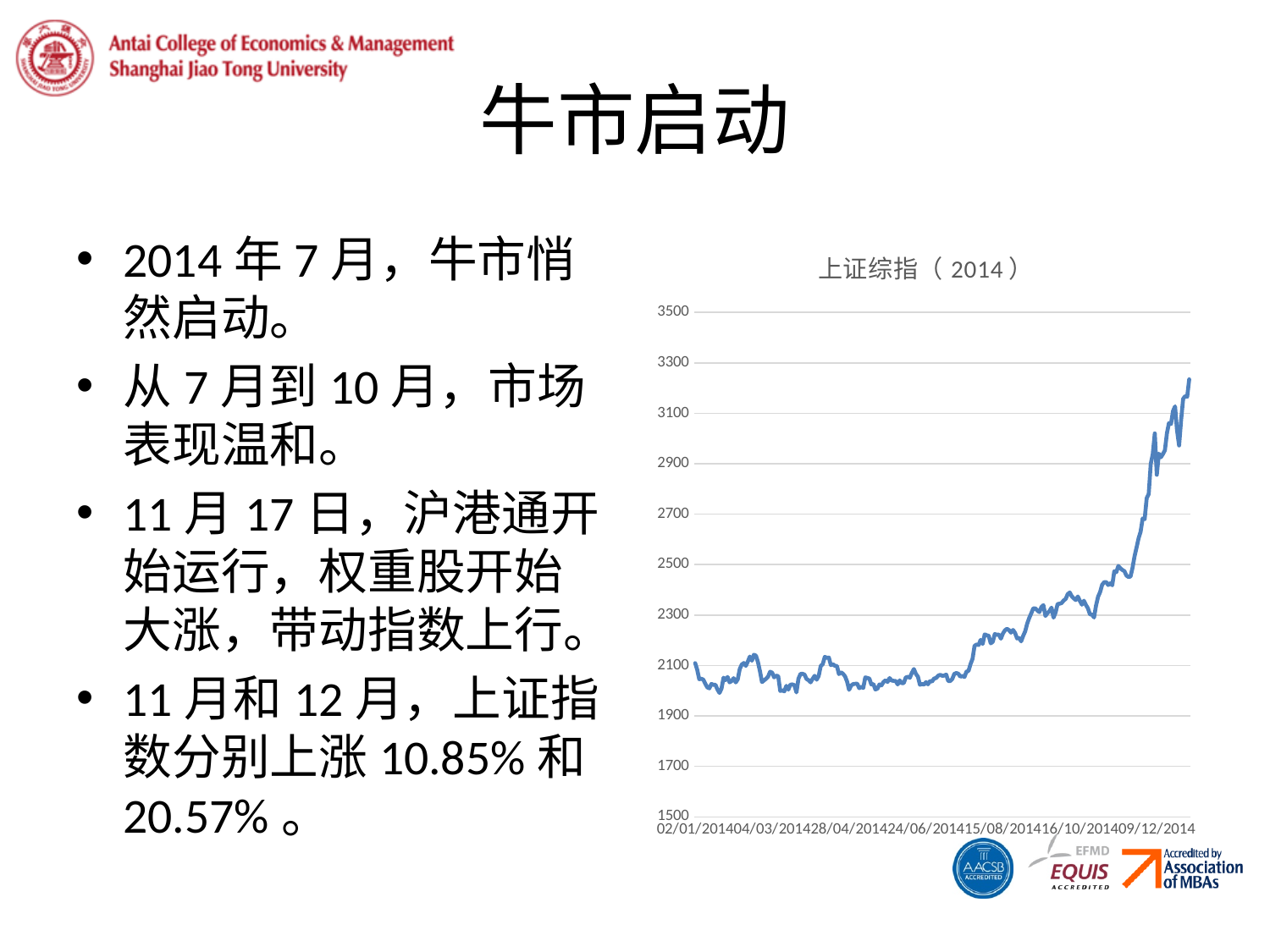
Which is higher in the chart: the index value at 02/01/2014 or at 09/12/2014? 09/12/2014 Is the index value at 09/12/2014 greater or less than 3000? less What kind of chart is shown on the slide? line chart Is the index value at 24/06/2014 greater or less than 2300? less How many date labels are shown along the x axis of the chart? 7 What is the title of the chart on the slide? 上证综指（2014） Is the index value at 09/12/2014 greater or less than 3300? less What is the lowest value shown on the y axis of the chart? 1500 Does the index generally rise or fall over the course of 2014 in the chart? rise How many data series are plotted in the chart? 1